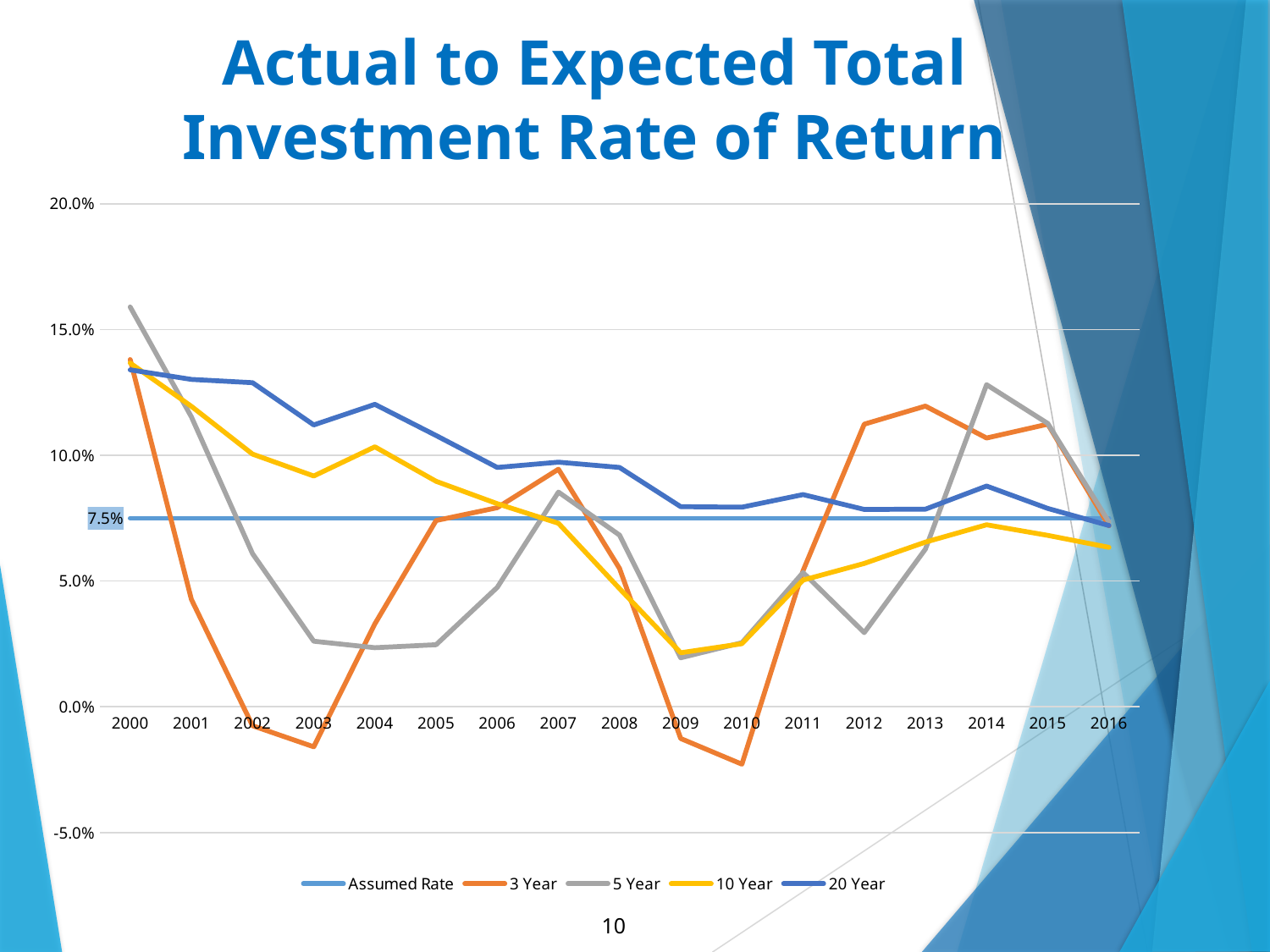
Is the value for 5 Year in 2000 greater or less than 15.0%? greater Is the value for 3 Year in 2010 greater or less than 0.0%? less Is the value for 10 Year in 2009 greater or less than 5.0%? less Which series has the highest value in 2000? 5 Year Which series has the lowest value in 2003? 3 Year In 2014, which is higher, the 5 Year line or the 10 Year line? 5 Year Does the 3 Year line rise or fall from 2000 to 2003? fall How many years are shown along the x axis? 17 What is the value of the Assumed Rate line? 7.5% What kind of chart is shown on the slide? line chart How many series does the legend list? 5